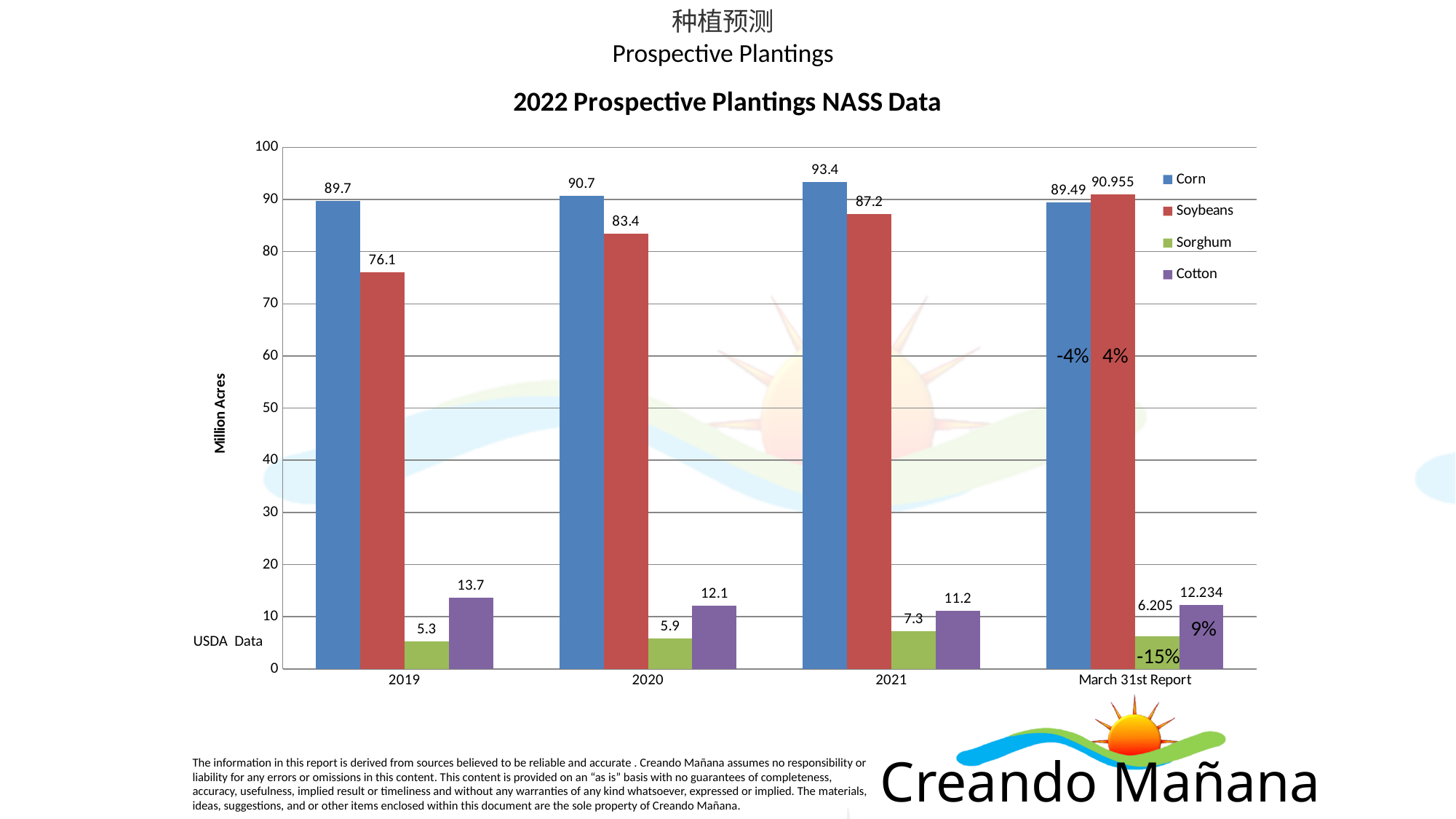
What is the Sorghum value for 2019? 5.3 What is the difference between the Corn and Soybeans values in 2019? 13.6 What is the Soybeans value for the March 31st Report? 90.955 What kind of chart is shown? Bar chart How many categories are shown on the x axis? 4 In which year or report is the Soybeans value lowest? 2019 In which year or report is the Corn value highest? 2021 What is the Corn value for 2021? 93.4 What is the Cotton value for 2020? 12.1 Does the Sorghum value rise or fall from 2019 to 2021? Rise Which is larger in the March 31st Report, Corn or Soybeans? Soybeans How many series does the legend list? 4